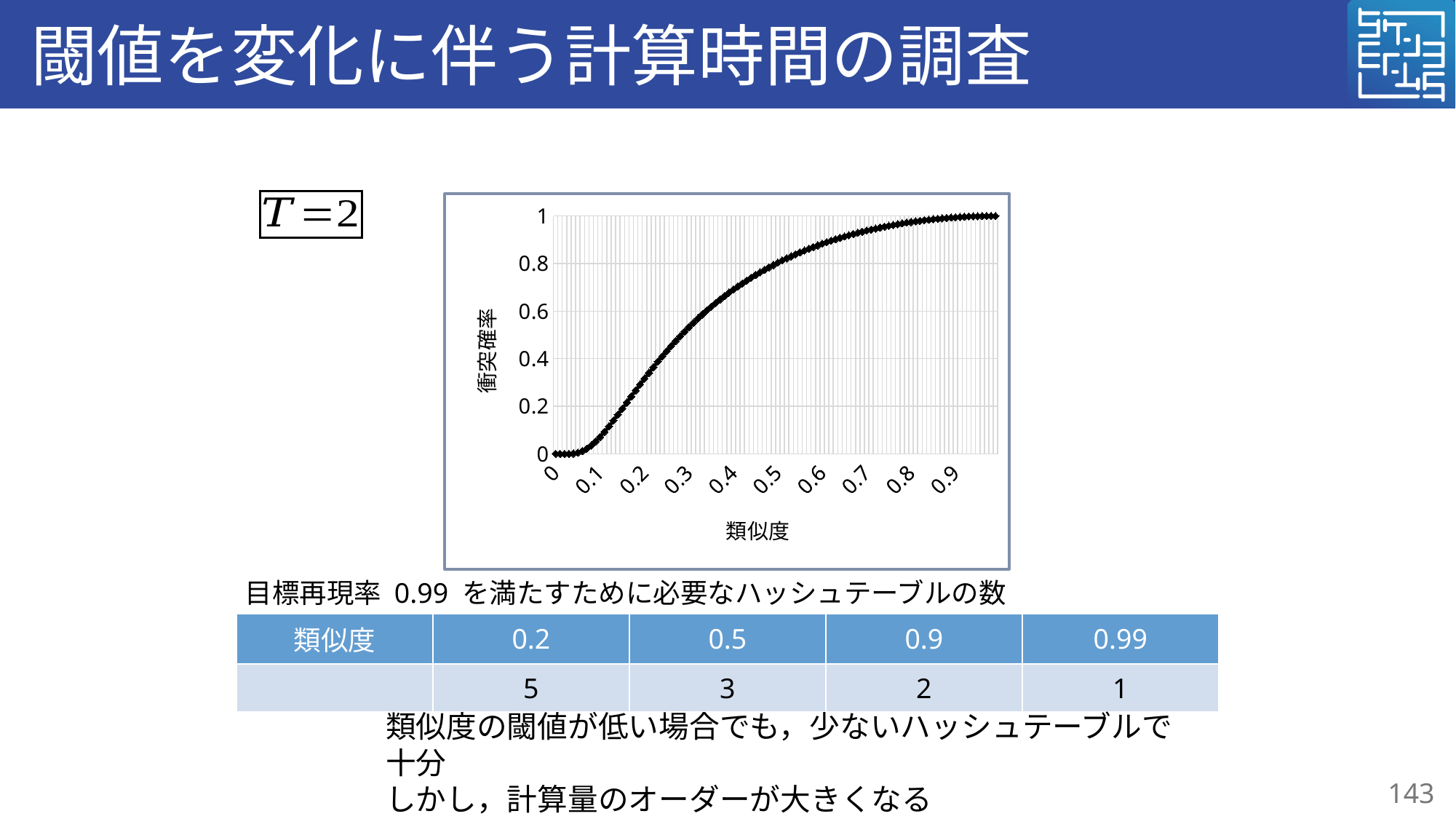
What is the label of the y axis of the chart? 衝突確率 Is the collision probability (衝突確率) at similarity (類似度) 0.1 greater or less than 0.2? less Does the collision probability (衝突確率) rise or fall as similarity (類似度) increases along the x axis? rise At which end of the x axis is the collision probability (衝突確率) lowest: similarity (類似度) 0 or similarity 0.9? 0 Which has the larger collision probability (衝突確率): similarity (類似度) 0.2 or similarity 0.8? 0.8 Is the collision probability (衝突確率) at similarity (類似度) 0.9 greater or less than 0.8? greater Is the collision probability (衝突確率) at similarity (類似度) 0.5 greater or less than 0.6? greater What kind of chart is shown on the slide? line chart What is the collision probability (衝突確率) at similarity (類似度) 0? 0 What is the label of the x axis of the chart? 類似度